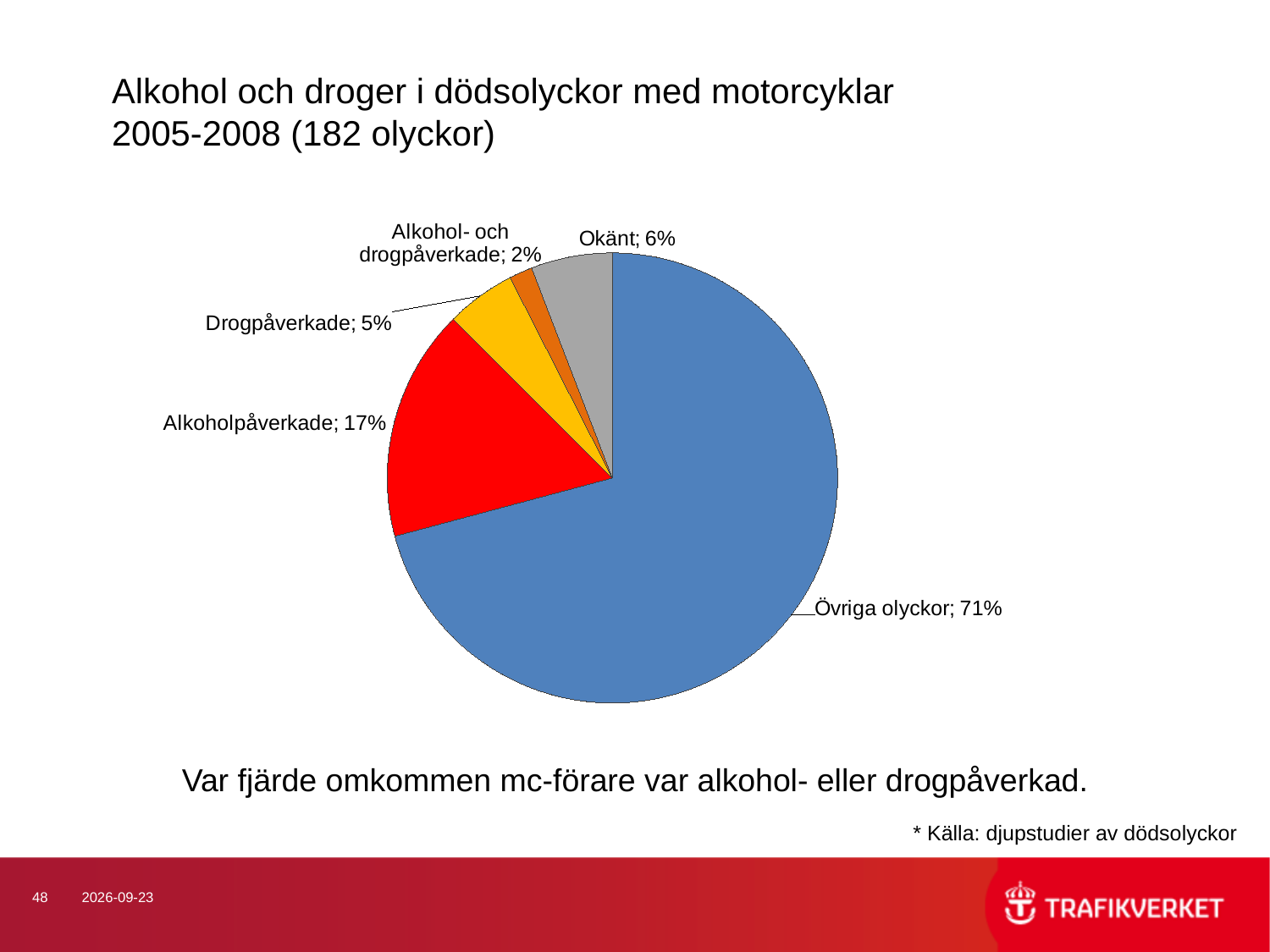
What share of the pie does Alkoholpåverkade represent? 17% Which slice of the pie is the smallest? Alkohol- och drogpåverkade What share of the pie does Övriga olyckor represent? 71% What kind of chart is shown on the slide? pie chart What colour is the Alkoholpåverkade slice? red What is the value shown for Alkohol- och drogpåverkade? 2% What is the value shown for Drogpåverkade? 5% Which is larger, the share for Okänt or the share for Drogpåverkade? Okänt What is the difference in percentage points between Alkoholpåverkade and Drogpåverkade? 12 What is the value shown for Okänt? 6% Which slice of the pie is the largest? Övriga olyckor How many slices does the pie chart have? 5